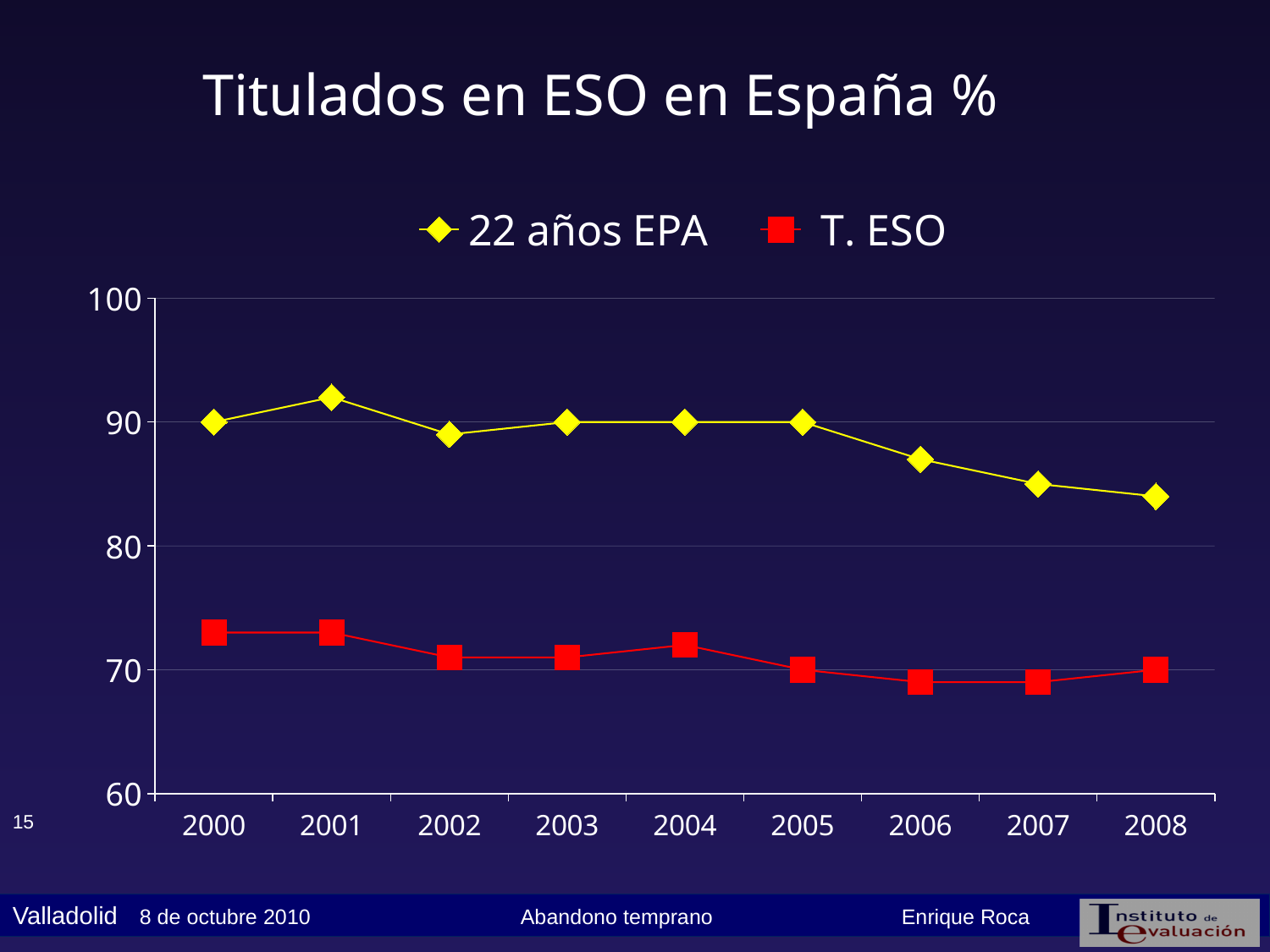
What type of chart is shown on the slide? line chart Is the value of 22 años EPA in 2001 greater or less than 90? greater In which year does the 22 años EPA series reach its lowest value? 2008 How many series does the legend list? 2 Is the value of T. ESO in 2000 greater or less than 70? greater Which series has the larger value in 2004, 22 años EPA or T. ESO? 22 años EPA Does the 22 años EPA series rise or fall overall from 2000 to 2008? fall What is the title of the chart? Titulados en ESO en España % Is the value of 22 años EPA in 2008 greater or less than 90? less In which year does the 22 años EPA series reach its highest value? 2001 How many years are plotted along the x axis? 9 Which series is drawn in yellow with diamond markers? 22 años EPA